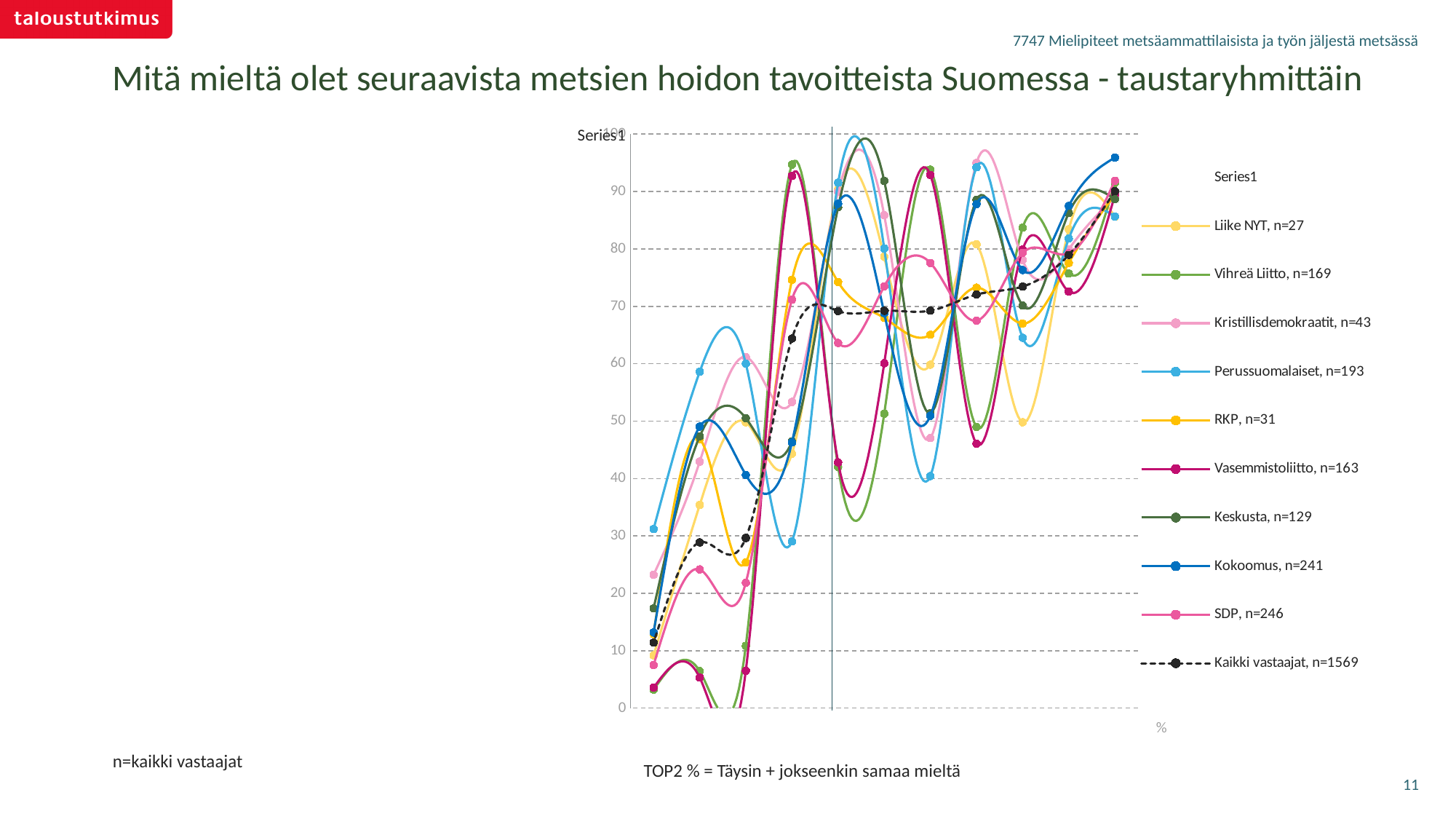
What kind of chart is shown on the slide? line chart Is the value of the rightmost point on the Perussuomalaiset line greater or less than 90? less Is the value of the leftmost point on the Vasemmistoliitto line greater or less than 10? less Which series in the legend is drawn with a dashed black line? Kaikki vastaajat, n=1569 How many series does the chart legend list? 11 According to the legend, what is the sample size (n) for Kokoomus? 241 Is the value of the rightmost point on the Kokoomus line greater or less than 90? greater